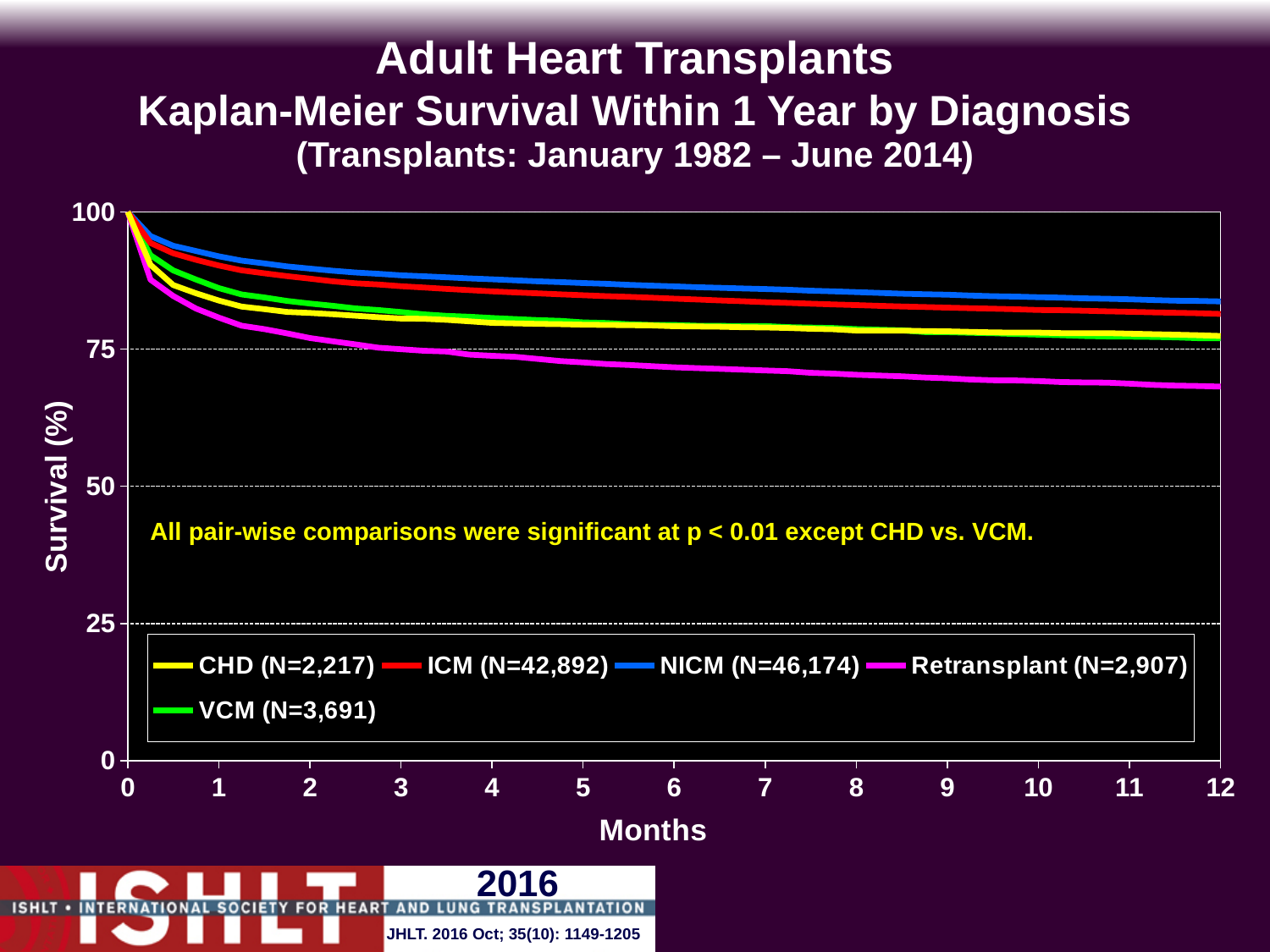
At 12 months, which has higher survival, CHD or Retransplant? CHD What kind of chart is shown on the slide? line chart Which diagnosis group has the lowest survival at 12 months? Retransplant At 12 months, which has higher survival, NICM or ICM? NICM Is the survival for Retransplant at 12 months greater or less than 75? less Is the survival for NICM at 12 months greater or less than 75? greater Which diagnosis group has the highest survival at 12 months? NICM Is the survival for Retransplant at 12 months greater or less than 50? greater What is the N shown in the legend for ICM? 42,892 Do the survival curves rise or fall as months increase? fall How many series does the legend list? 5